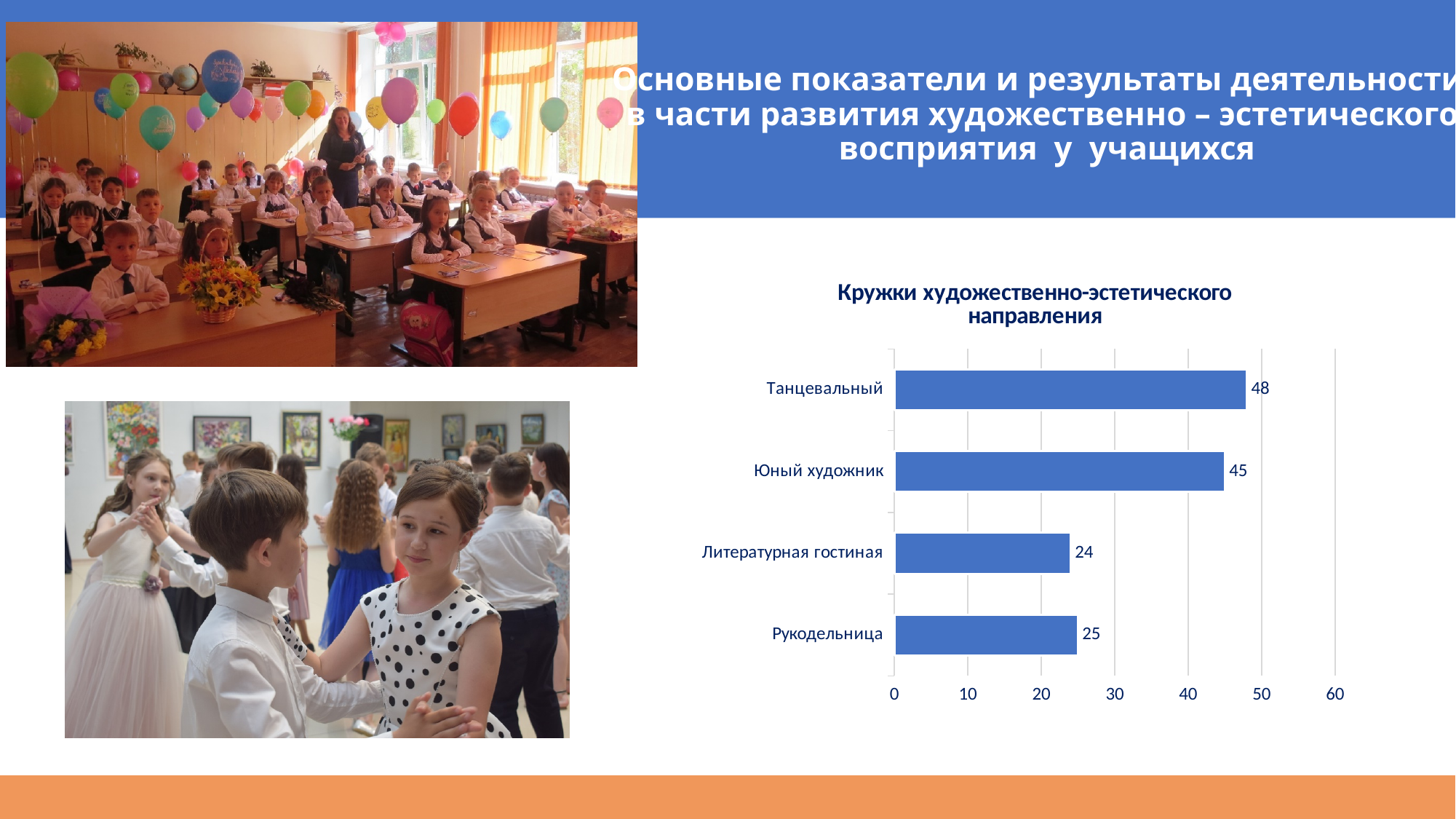
What is the title of the chart? Кружки художественно-эстетического направления Which category has the highest value? Танцевальный What is the difference between the values for Танцевальный and Литературная гостиная? 24 Which is larger, the value for Юный художник or the value for Рукодельница? Юный художник Which category has the lowest value? Литературная гостиная What is the difference between the values for Танцевальный and Юный художник? 3 How many categories are shown in the chart? 4 What is the value for Юный художник? 45 What is the value for Танцевальный? 48 What is the value for Рукодельница? 25 What is the value for Литературная гостиная? 24 What kind of chart is shown on the slide? bar chart